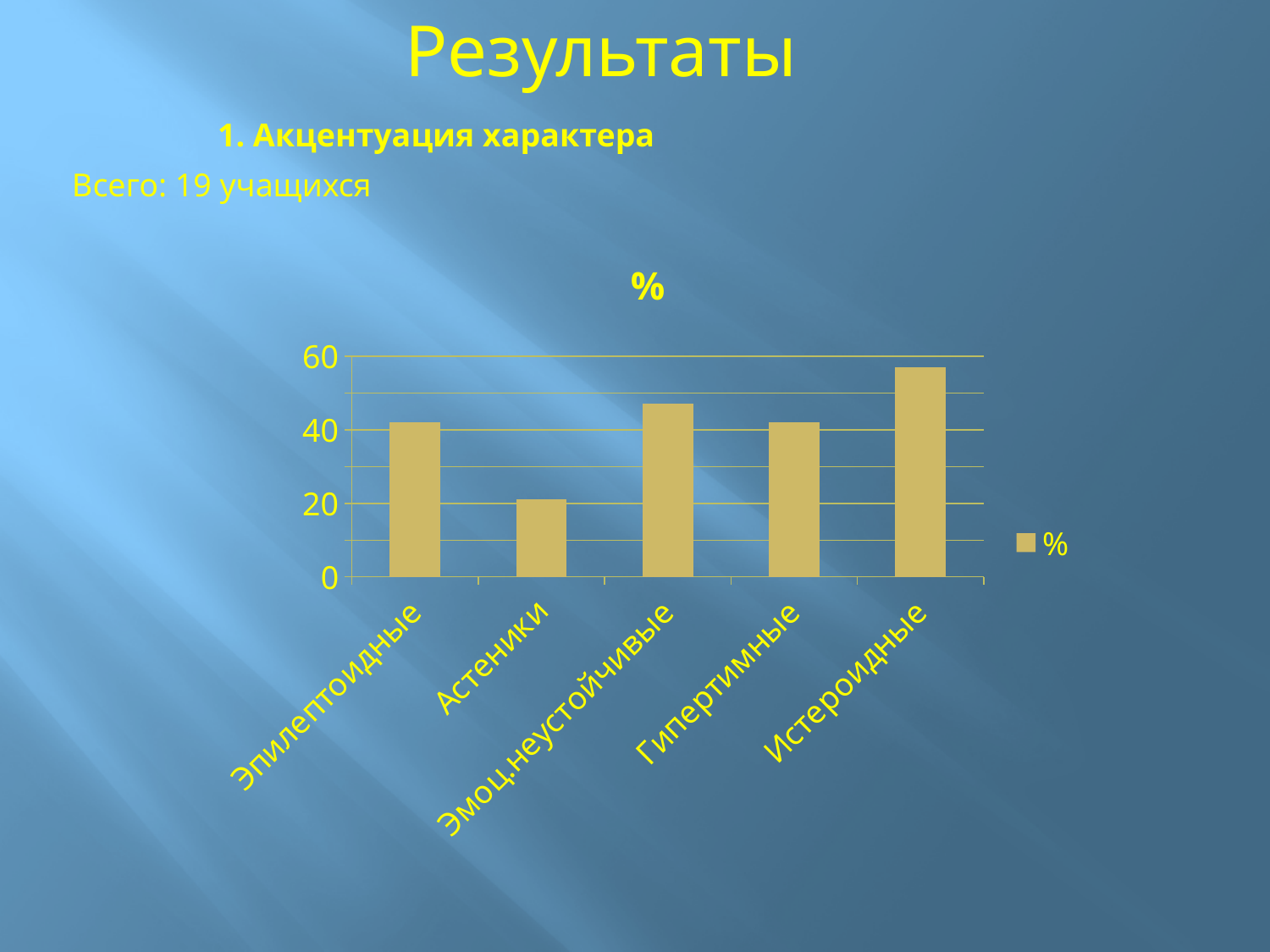
What is the title of the chart? % Is the value for Астеники greater or less than 40? less How many series does the chart's legend list? 1 Which is larger, the value for Астеники or the value for Гипертимные? Гипертимные Which is larger, the value for Истероидные or the value for Эмоц.неустойчивые? Истероидные Is the value for Гипертимные greater or less than 60? less Which category has the lowest bar in the chart? Астеники Which category has the highest bar in the chart? Истероидные Is the value for Эмоц.неустойчивые greater or less than 40? greater How many categories are plotted on the x axis of the chart? 5 What kind of chart is shown on the slide? bar chart